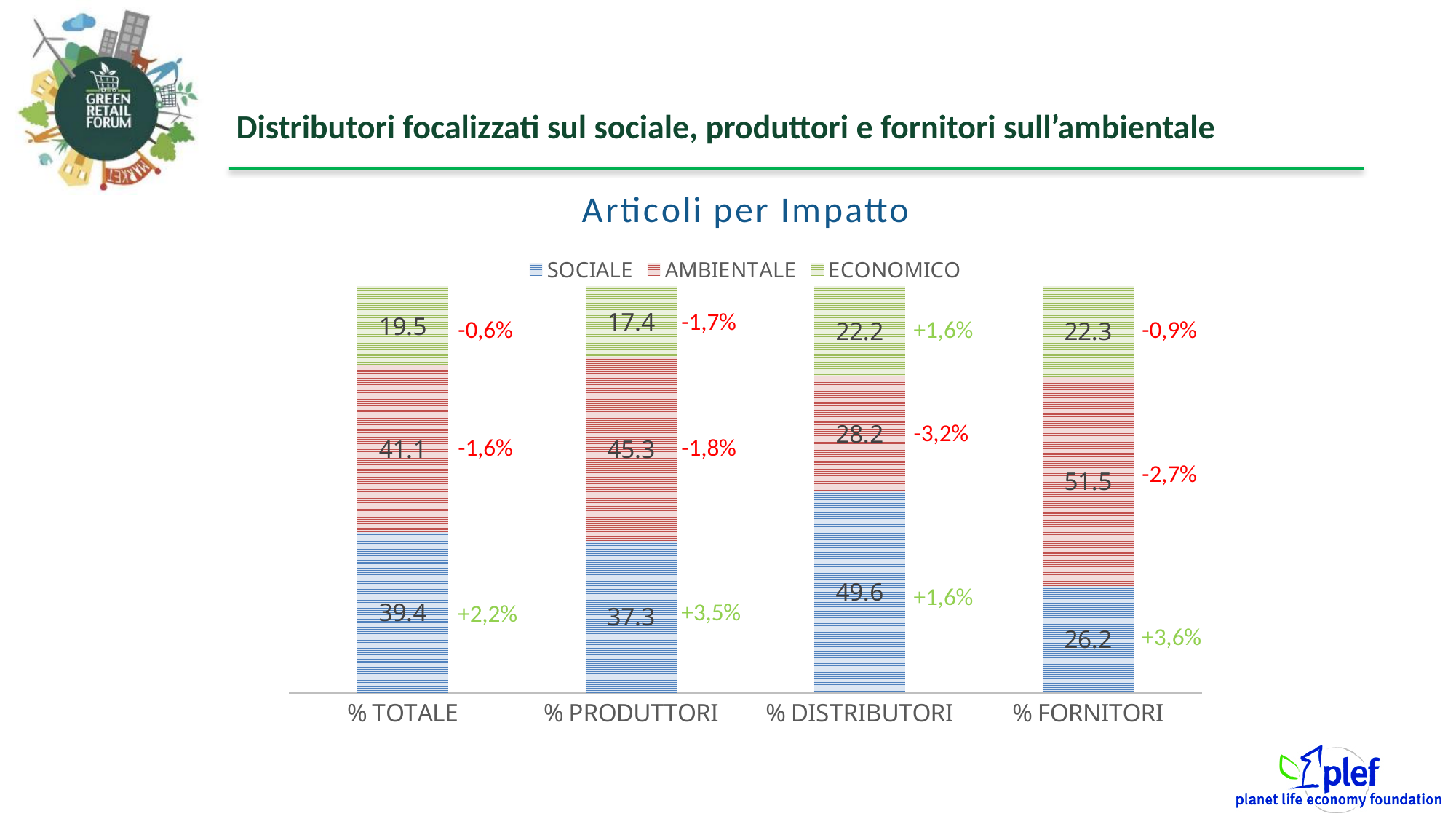
Which is larger, the SOCIALE value for % TOTALE or the SOCIALE value for % PRODUTTORI? % TOTALE Which category has the lowest ECONOMICO value? % PRODUTTORI What kind of chart is shown? Stacked bar chart What is the title of the chart? Articoli per Impatto What is the SOCIALE value for % DISTRIBUTORI? 49.6 How many categories are shown on the x axis? 4 How many series does the legend list? 3 Which category has the highest SOCIALE value? % DISTRIBUTORI What is the ECONOMICO value for % TOTALE? 19.5 What is the difference between the AMBIENTALE values for % FORNITORI and % DISTRIBUTORI? 23.3 What is the AMBIENTALE value for % FORNITORI? 51.5 What is the AMBIENTALE value for % PRODUTTORI? 45.3